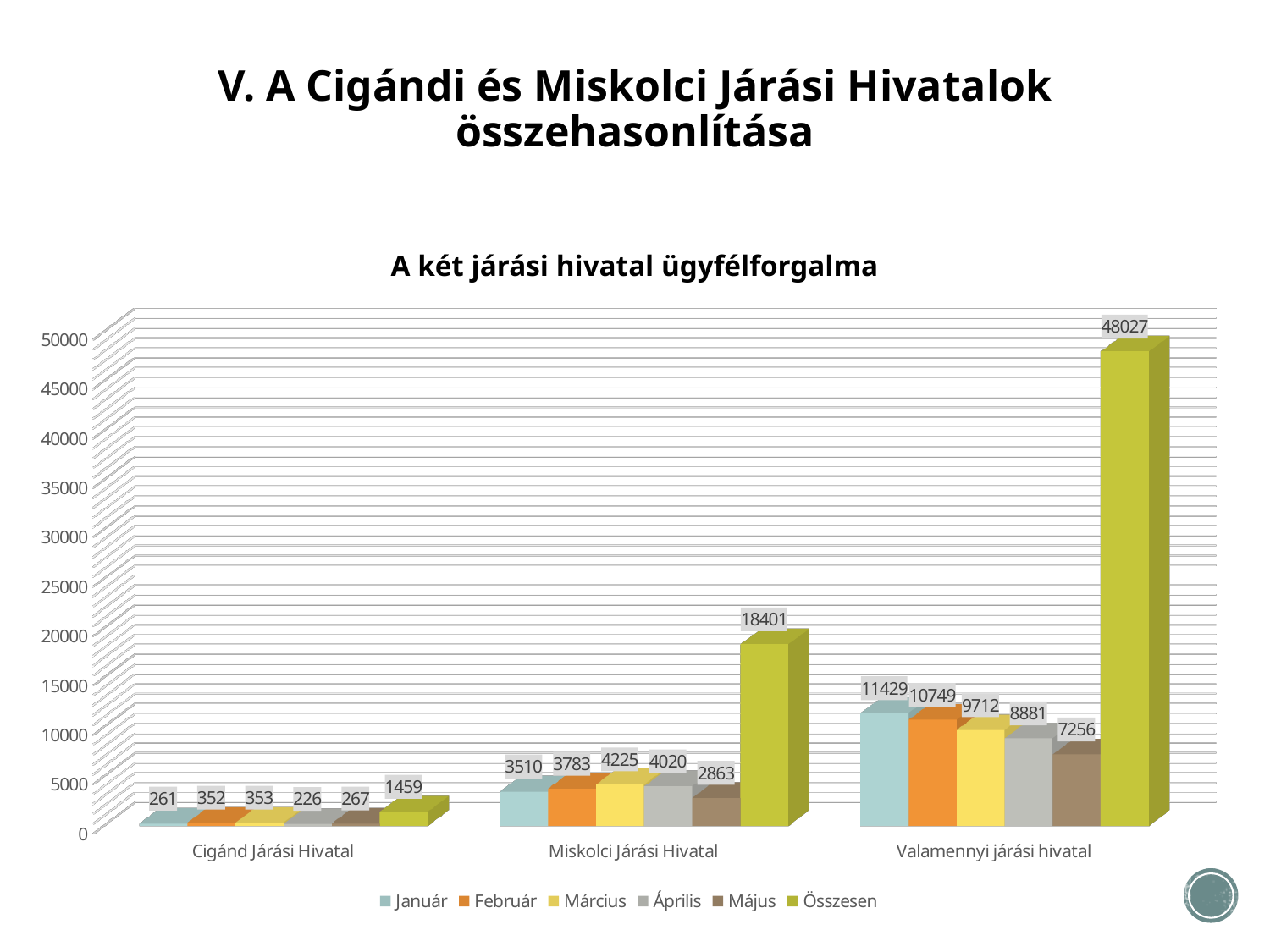
Which is larger for Valamennyi járási hivatal: the Január value or the Február value? Január How many categories are shown on the x axis? 3 How many series does the legend list? 6 What is the difference between the Március and Május values for Miskolci Járási Hivatal? 1362 Which month has the lowest value for Cigánd Járási Hivatal? Április What is the Összesen value for Miskolci Járási Hivatal? 18401 What is the Január value for Cigánd Járási Hivatal? 261 What is the title of the chart? A két járási hivatal ügyfélforgalma Is the Összesen value for Miskolci Járási Hivatal greater or less than 20000? less Which category has the highest Összesen value? Valamennyi járási hivatal What kind of chart is shown? bar chart What is the Május value for Valamennyi járási hivatal? 7256